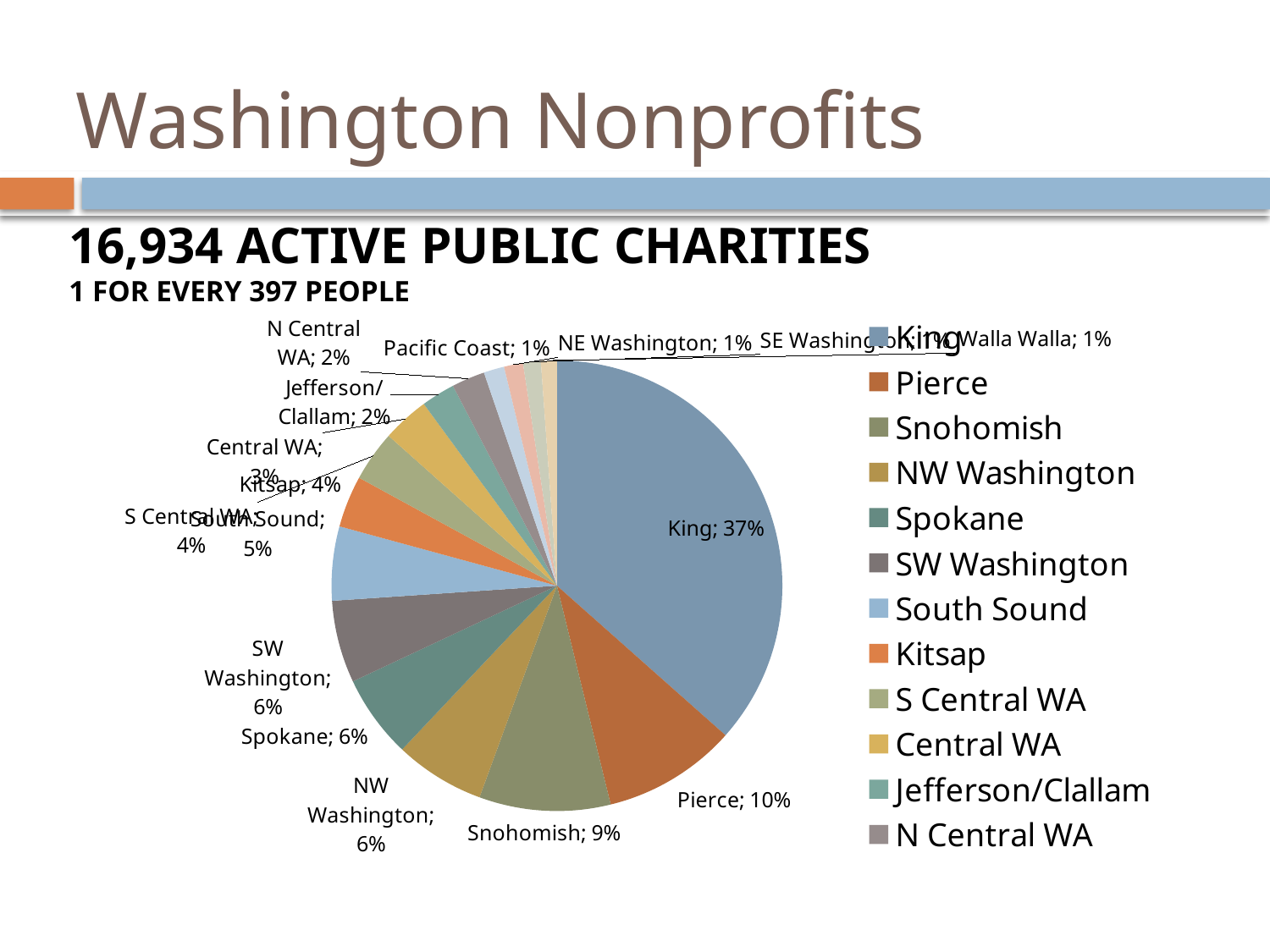
Which is larger, the slice for South Sound or the slice for Kitsap? South Sound What percentage is shown for South Sound? 5% Which region has the largest slice of the pie chart? King What is the difference in percentage points between Pierce and Snohomish? 1% What kind of chart is shown on the slide? Pie chart What is the value shown for Pierce in the pie chart? 10% Which is larger, the slice for Pierce or the slice for Snohomish? Pierce What is the combined share of King and Pierce in the pie chart? 47% What percentage of the pie chart does King account for? 37% What is the value shown for Kitsap? 4% What is the difference in percentage points between King and Pierce? 27% What percentage is shown for Snohomish? 9%